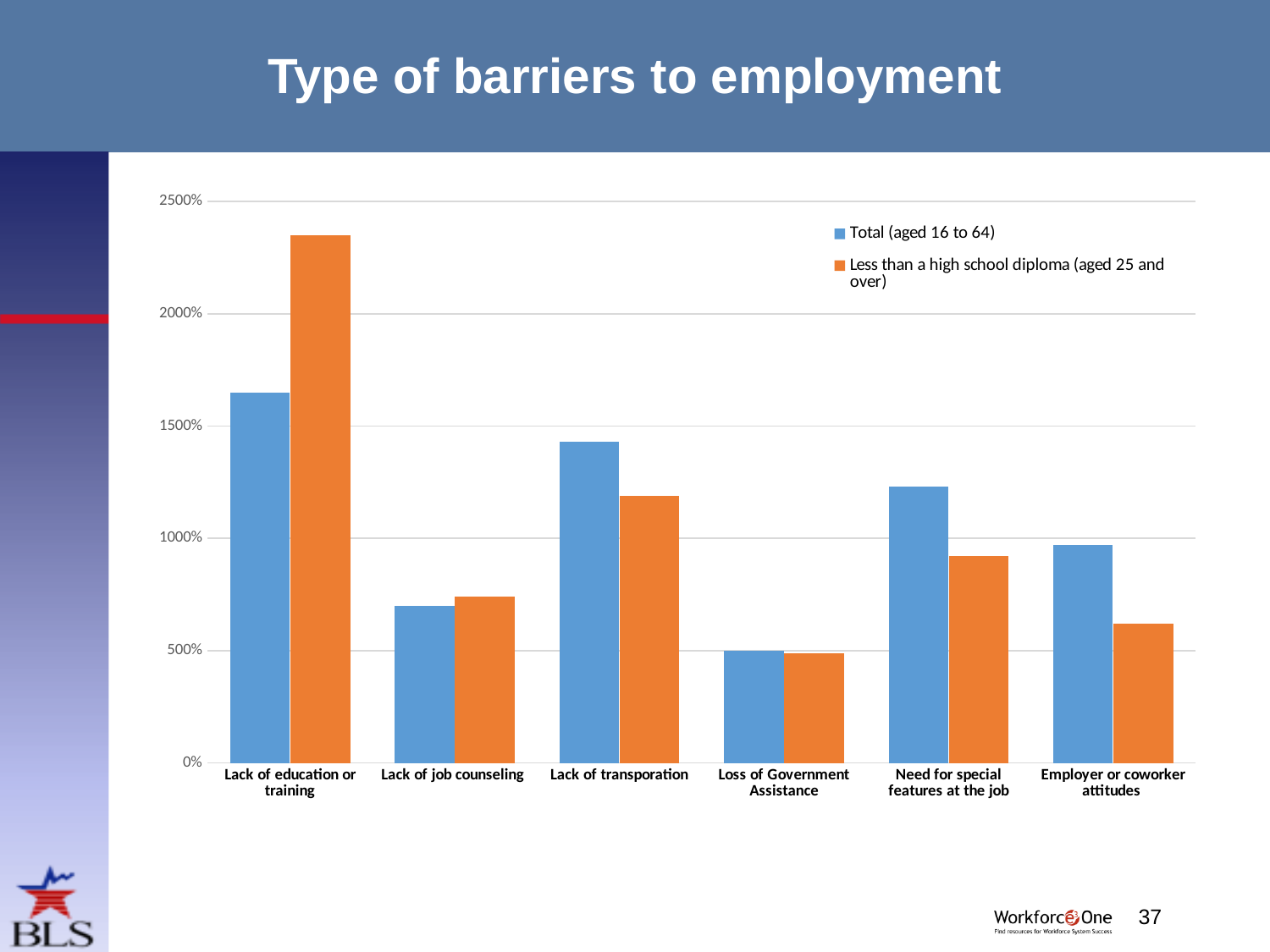
Is the Less than a high school diploma (aged 25 and over) value for Lack of education or training greater or less than 2000%? greater How many series does the legend list? 2 Which category has the highest value for the Less than a high school diploma (aged 25 and over) series? Lack of education or training Is the Total (aged 16 to 64) value for Lack of transporation greater or less than 1500%? less Which category has the highest value for the Total (aged 16 to 64) series? Lack of education or training Is the Less than a high school diploma (aged 25 and over) value for Need for special features at the job greater or less than 1000%? less Which category has the lowest value for the Less than a high school diploma (aged 25 and over) series? Loss of Government Assistance What is the title of the chart on the slide? Type of barriers to employment For Lack of education or training, which series has the larger value: Total (aged 16 to 64) or Less than a high school diploma (aged 25 and over)? Less than a high school diploma (aged 25 and over) For Lack of transporation, which series has the larger value: Total (aged 16 to 64) or Less than a high school diploma (aged 25 and over)? Total (aged 16 to 64) How many barrier categories are shown on the x axis? 6 What kind of chart is shown on the slide? Bar chart